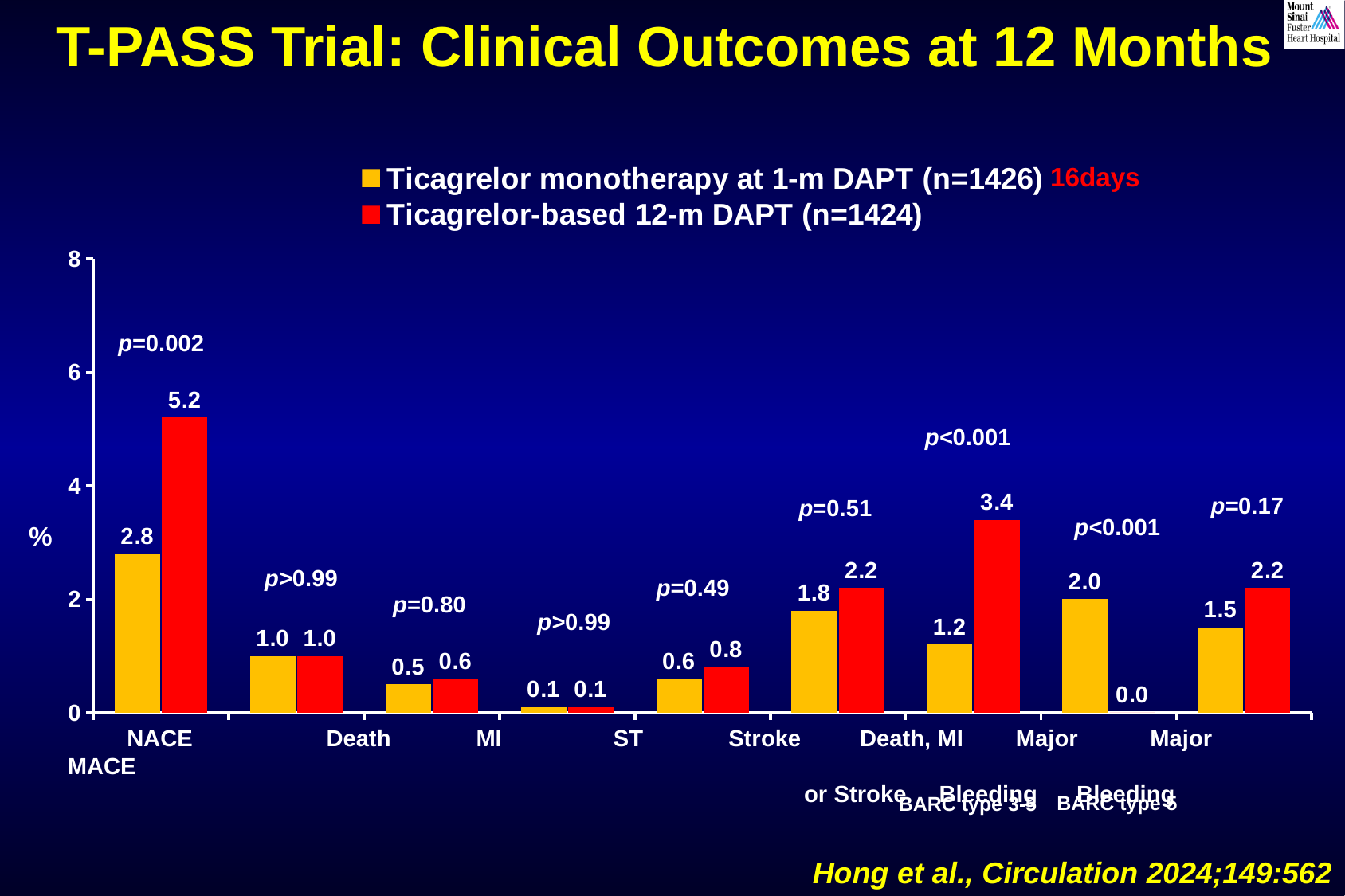
What is the Death value for Ticagrelor monotherapy at 1-m DAPT (n=1426)? 1.0 How many series does the legend list? 2 Which category has the highest value for Ticagrelor-based 12-m DAPT (n=1424)? NACE What is the p-value shown for NACE? p=0.002 What is the NACE value for Ticagrelor-based 12-m DAPT (n=1424)? 5.2 What is the ST value for Ticagrelor-based 12-m DAPT (n=1424)? 0.1 What is the NACE value for Ticagrelor monotherapy at 1-m DAPT (n=1426)? 2.8 Which series has the higher value for Death, MI or Stroke? Ticagrelor-based 12-m DAPT (n=1424) What is the Stroke value for Ticagrelor-based 12-m DAPT (n=1424)? 0.8 What type of chart is shown on the slide? bar chart What is the value for Death, MI or Stroke for Ticagrelor monotherapy at 1-m DAPT (n=1426)? 1.8 What is the difference in NACE between Ticagrelor-based 12-m DAPT and Ticagrelor monotherapy at 1-m DAPT? 2.4